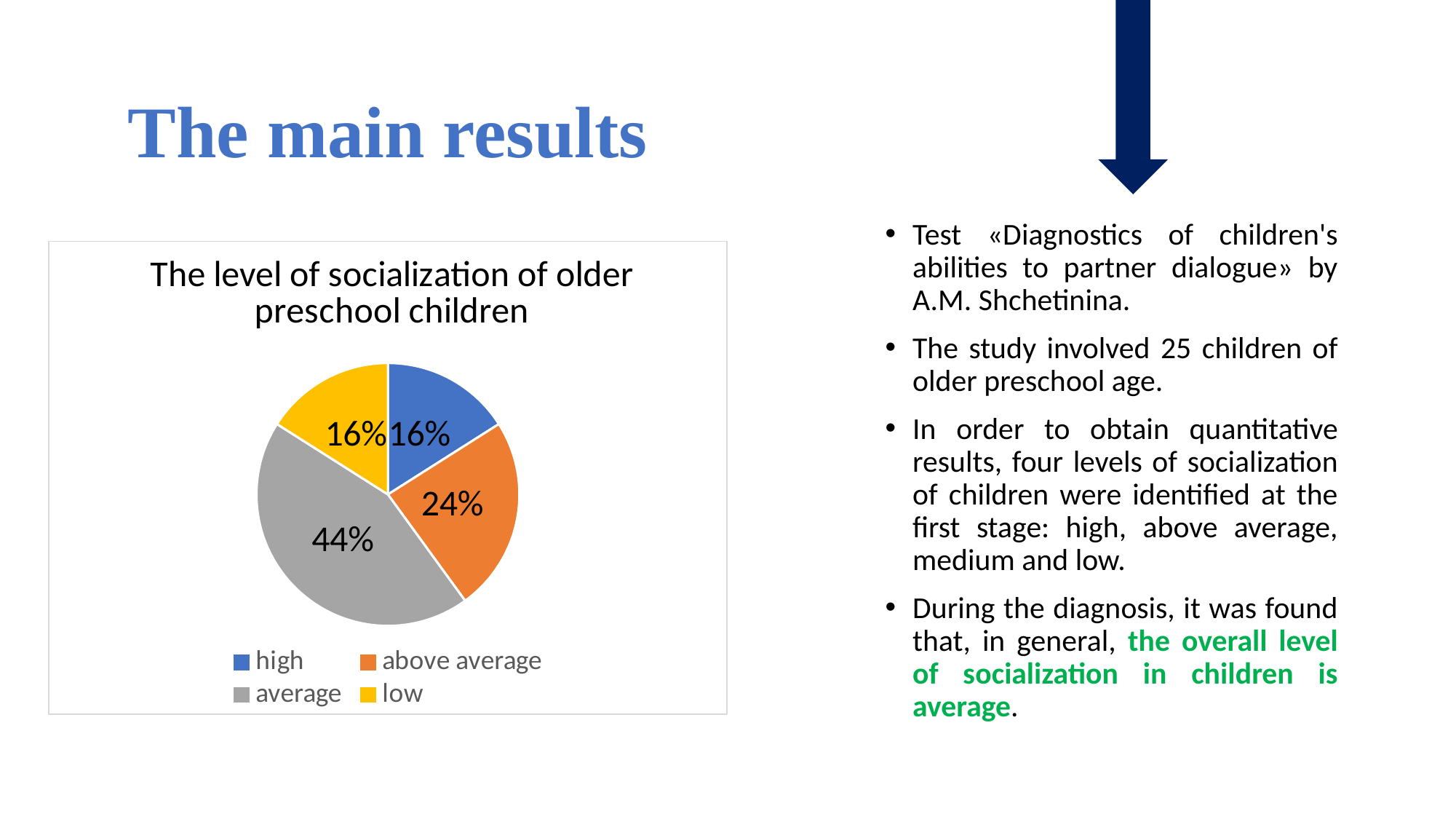
What is the title of the chart? The level of socialization of older preschool children Which level of socialization has the largest share of the pie? average What percentage of children have an average level of socialization? 44% What type of chart is shown on the slide? pie chart How many categories does the pie chart show? 4 What is the difference between the share for average and the share for above average? 20% What percentage of children have a high level of socialization? 16% What colour represents the average category in the pie chart? grey What is the combined share of the high and low categories? 32% What percentage of children have an above average level of socialization? 24% What percentage of children have a low level of socialization? 16% Which is larger, the share for above average or the share for high? above average